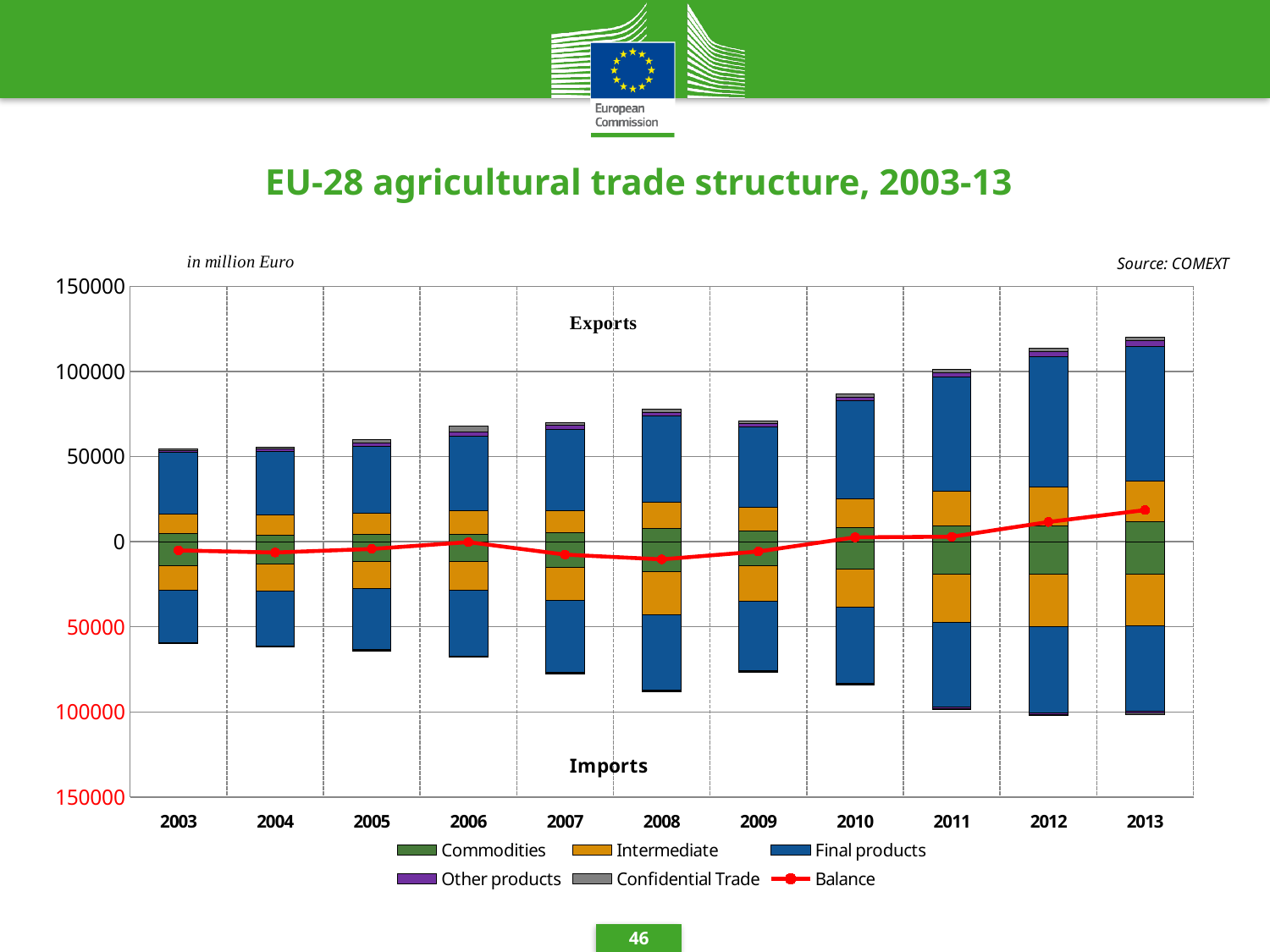
Is the total exports value for 2003 greater or less than 100000? less Do total exports generally rise or fall from 2003 to 2013? rise What is the title of the chart? EU-28 agricultural trade structure, 2003-13 In which year is the Balance line at its lowest point? 2008 Is the total exports value for 2010 greater or less than 50000? greater Is the total exports value for 2013 greater or less than 100000? greater What kind of chart is shown on the slide? Stacked bar chart with a line How many series does the legend list? 6 Which year has the highest total exports? 2013 In which year is the Balance line at its highest point? 2013 How many years are shown on the x axis of the chart? 11